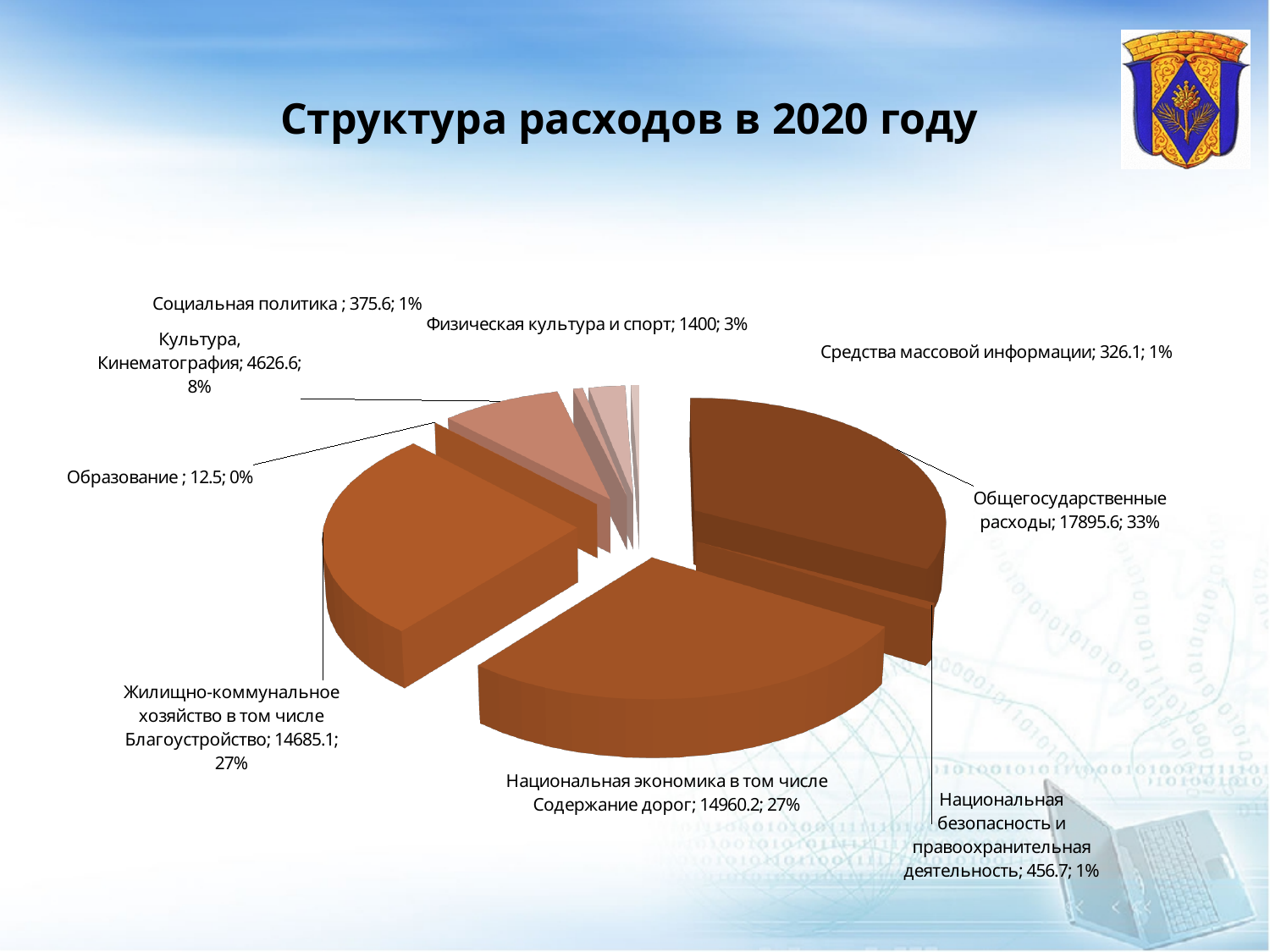
What is the value for Физическая культура и спорт? 1400 What is the value for Национальная безопасность и правоохранительная деятельность? 456.7 Which category has the smallest value? Образование Which is larger: the value for Национальная экономика в том числе Содержание дорог or for Жилищно-коммунальное хозяйство в том числе Благоустройство? Национальная экономика в том числе Содержание дорог What is the value for Культура, Кинематография? 4626.6 What kind of chart is shown on the slide? Pie chart What is the difference between the values for Общегосударственные расходы and Национальная экономика в том числе Содержание дорог? 2935.4 What is the value for Общегосударственные расходы? 17895.6 Which category has the largest share of the pie? Общегосударственные расходы What is the title of the chart on the slide? Структура расходов в 2020 году What share of the pie does Жилищно-коммунальное хозяйство в том числе Благоустройство represent? 27% How many categories (slices) does the pie chart have? 9